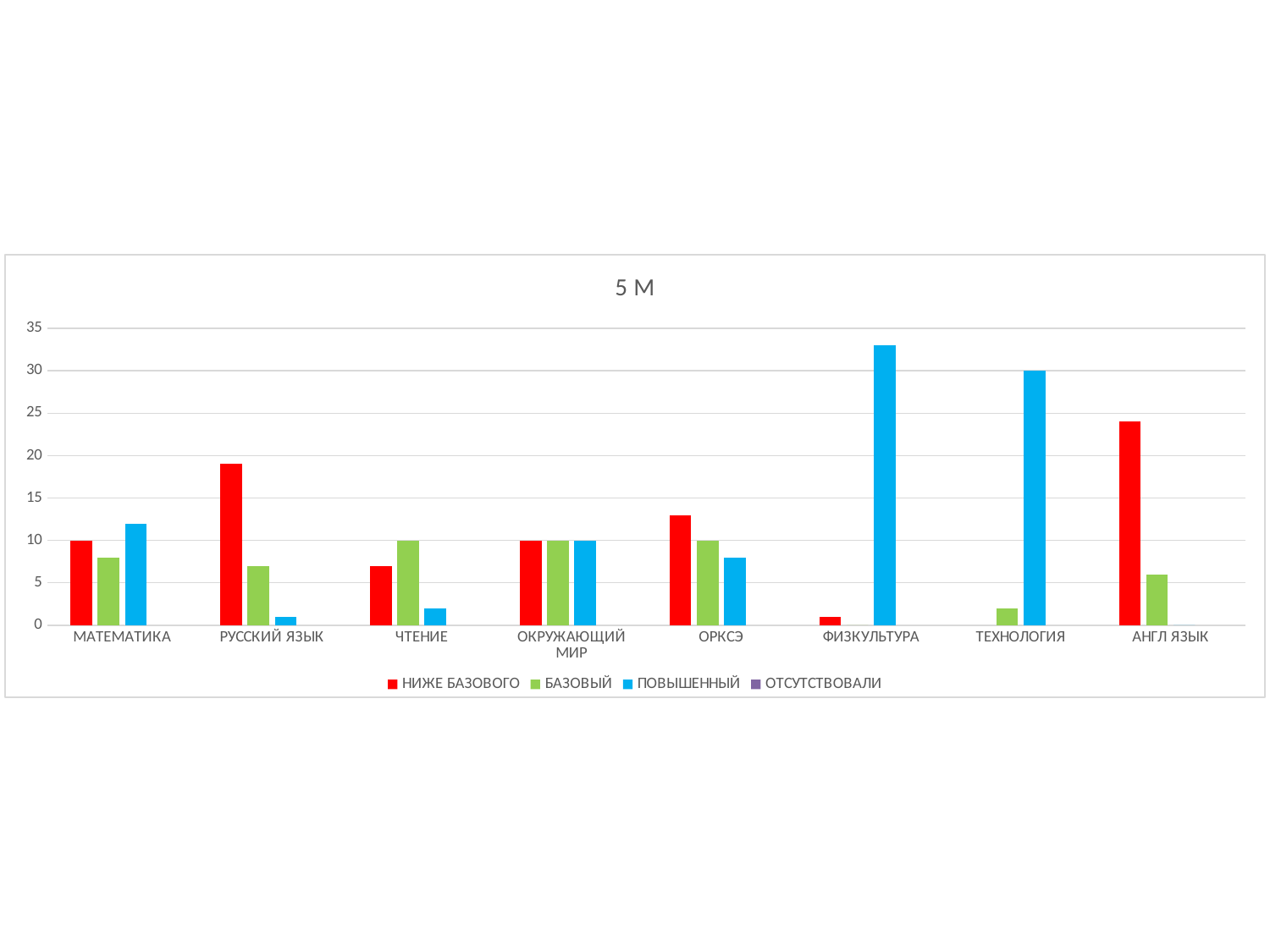
What kind of chart is shown on the slide? bar chart What is the ПОВЫШЕННЫЙ value for ТЕХНОЛОГИЯ? 30 Is the НИЖЕ БАЗОВОГО value for РУССКИЙ ЯЗЫК greater or less than 15? greater Which is larger for ЧТЕНИЕ: the НИЖЕ БАЗОВОГО value or the БАЗОВЫЙ value? БАЗОВЫЙ Which subject has the highest НИЖЕ БАЗОВОГО value? АНГЛ ЯЗЫК What is the НИЖЕ БАЗОВОГО value for ОКРУЖАЮЩИЙ МИР? 10 What is the title of the chart? 5 М How many series does the legend list? 4 How many subject categories are shown on the x axis? 8 Which subject has the highest ПОВЫШЕННЫЙ value? ФИЗКУЛЬТУРА Is the ПОВЫШЕННЫЙ value for ФИЗКУЛЬТУРА greater or less than 30? greater Which colour represents the ПОВЫШЕННЫЙ series? blue